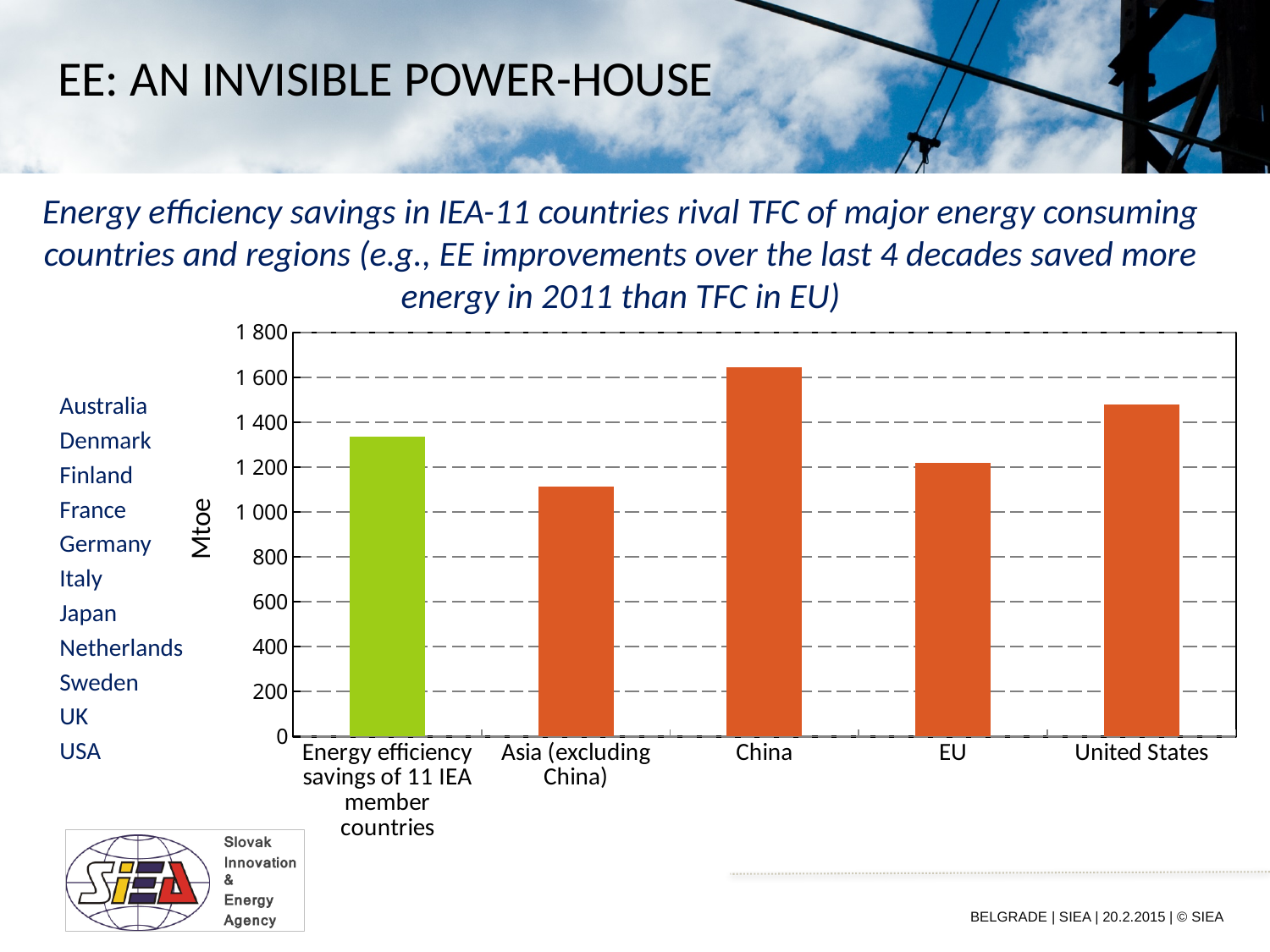
Which category has the highest bar in the chart? China Is the value for Asia (excluding China) greater or less than 1 000? greater Is the value for Energy efficiency savings of 11 IEA member countries greater or less than 1 200? greater How many categories (bars) are plotted in the chart? 5 What unit is shown on the vertical axis of the chart? Mtoe Is the value for China greater or less than 1 600? greater Which is larger, the value for United States or the value for EU? United States Which is larger, the value for Energy efficiency savings of 11 IEA member countries or the value for EU? Energy efficiency savings of 11 IEA member countries What kind of chart is shown on the slide? bar chart Which category has the lowest bar in the chart? Asia (excluding China)